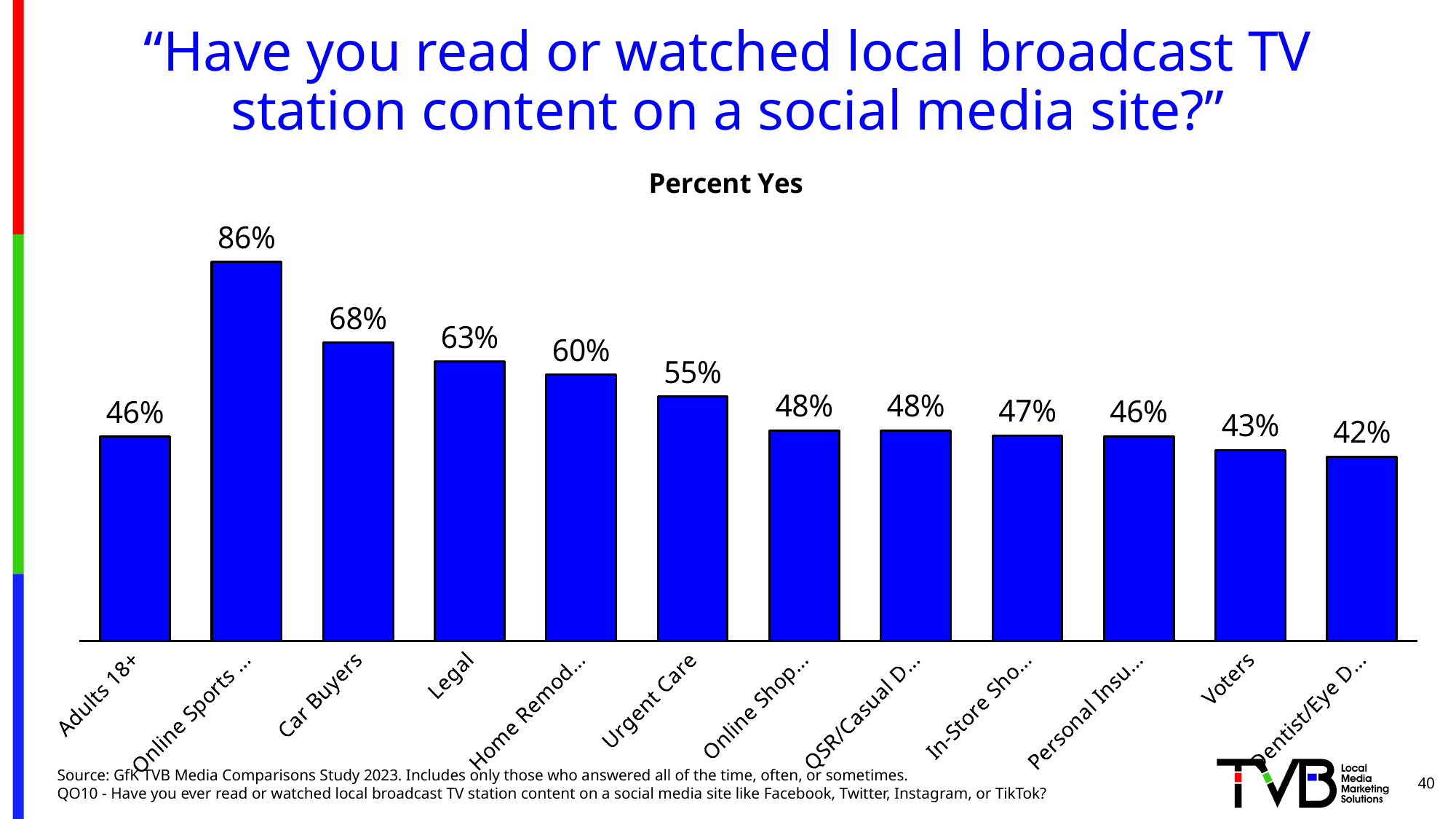
How many categories (bars) are shown on the chart? 12 What is the lowest Percent Yes value shown on the chart? 42% What is the Percent Yes value for Urgent Care? 55% Which has a higher Percent Yes, Urgent Care or Voters? Urgent Care What type of chart is shown on the slide? bar chart What is the title of the chart? Percent Yes What is the Percent Yes value for Legal? 63% What is the Percent Yes value for Voters? 43% What is the Percent Yes value for Adults 18+? 46% What is the highest Percent Yes value shown on the chart? 86% What is the Percent Yes value for Car Buyers? 68% What is the difference in Percent Yes between Car Buyers and Legal? 5%